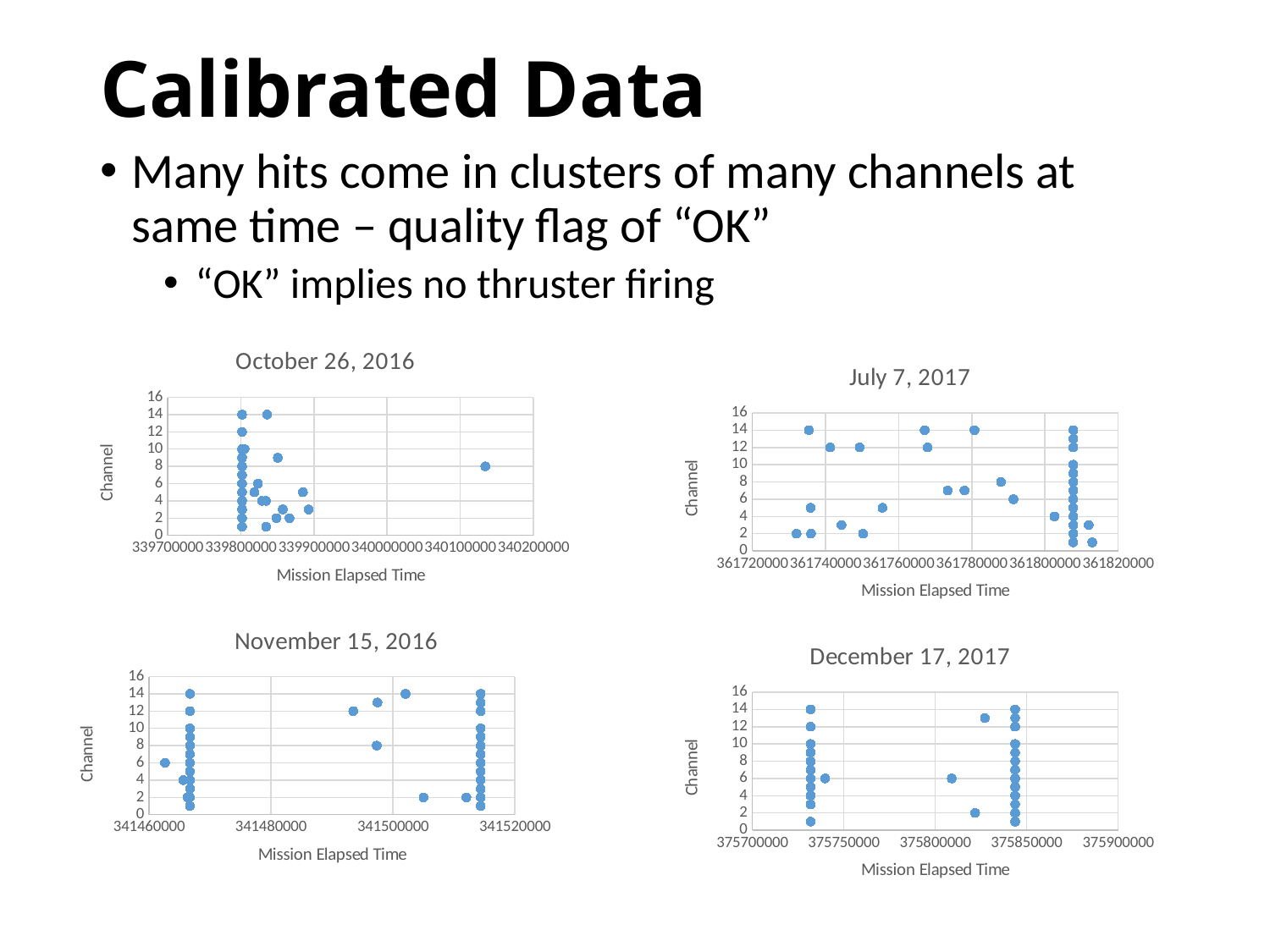
In the "December 17, 2017" chart, is the channel value of the point near 375830000 greater or less than 10? greater What kind of chart is the "December 17, 2017" chart? Scatter chart In the "October 26, 2016" chart, is the channel value of the isolated point near 340100000 greater or less than 6? greater In the "December 17, 2017" chart, is the channel value of the point near 375820000 greater or less than 4? less What kind of chart is the "October 26, 2016" chart? Scatter chart What is the x-axis title of the "November 15, 2016" chart? Mission Elapsed Time What is the y-axis title of the "July 7, 2017" chart? Channel What is the highest tick value on the y axis of the "July 7, 2017" chart? 16